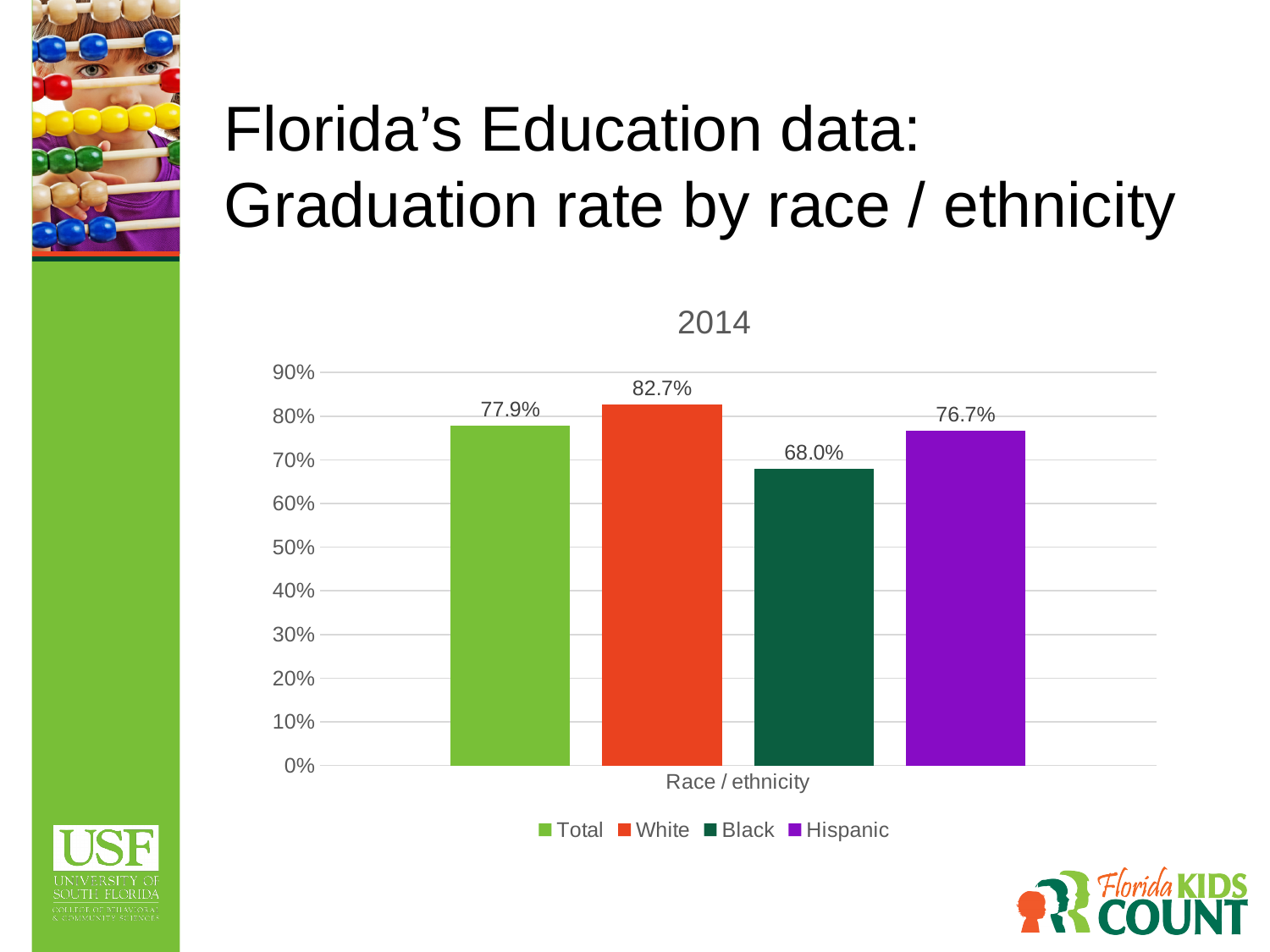
What is the Total graduation rate shown in the chart? 77.9% What is the difference between the White and Black graduation rates? 14.7% What is the graduation rate for Hispanic students? 76.7% Which group has the highest graduation rate? White What kind of chart is shown on the slide? bar chart How many series does the legend list? 4 Which group has the lowest graduation rate? Black What is the graduation rate for White students? 82.7% What is the graduation rate for Black students? 68.0% Which is larger, the graduation rate for Total or for Hispanic? Total Is the graduation rate for Black students greater or less than 70%? less What is the title of the chart? 2014